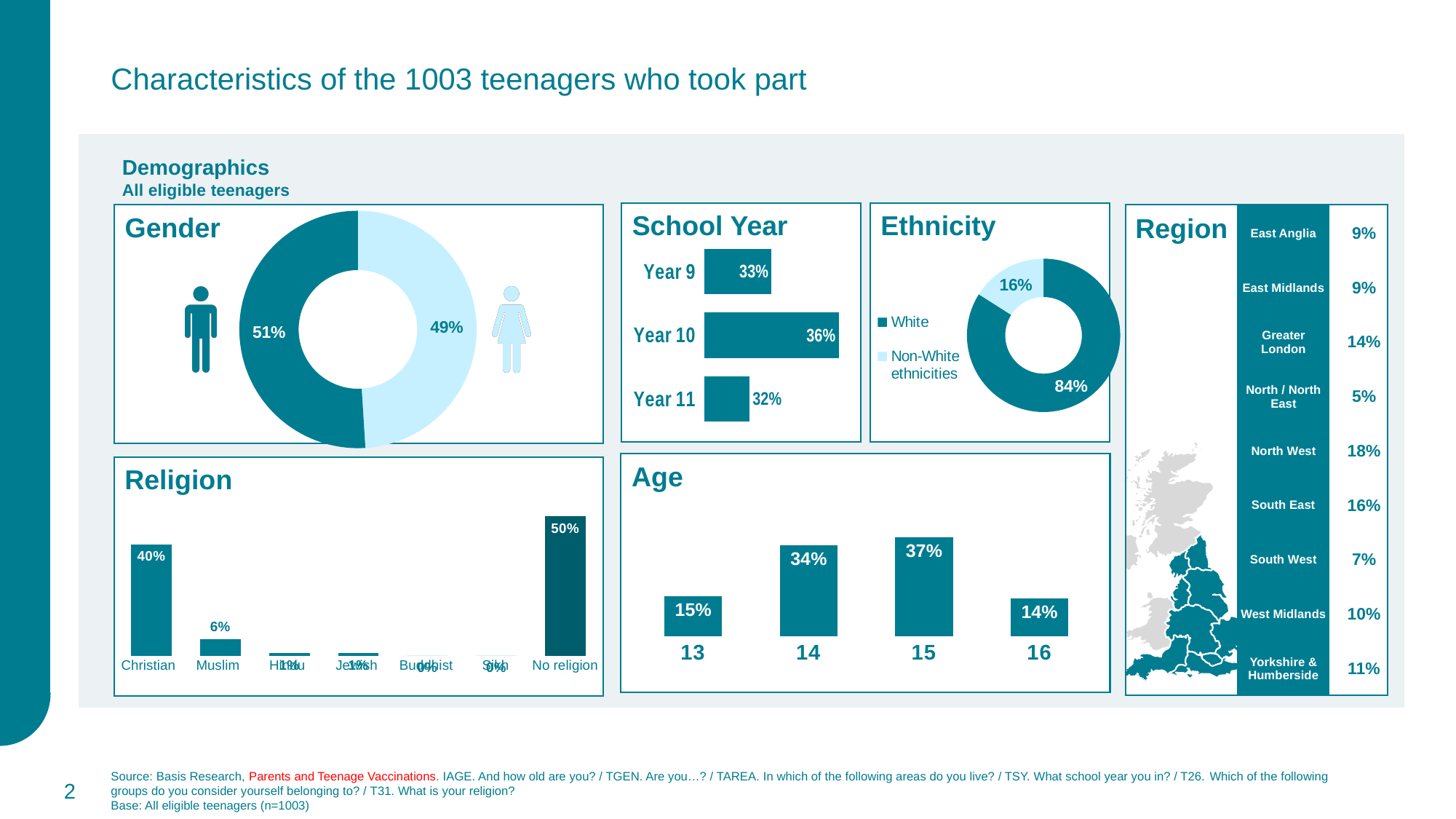
What kind of chart is the Gender chart? Donut (pie) chart In the School Year chart, which school year has the highest percentage? Year 10 In the Religion chart, what is the difference between Christian and Muslim? 34% In the Religion chart, which category has the highest value? No religion In the School Year chart, what is the difference between Year 10 and Year 11? 4% How many series does the legend of the Ethnicity chart list? 2 In the Age chart, which is larger, the value for age 13 or the value for age 16? 13 In the Religion chart, what is the value for No religion? 50% In the Ethnicity chart, what share of teenagers are White? 84% In the Age chart, which age has the highest percentage? 15 In the Gender chart, what percentage of teenagers are male (the darker slice)? 51% In the School Year chart, what is the value for Year 10? 36%